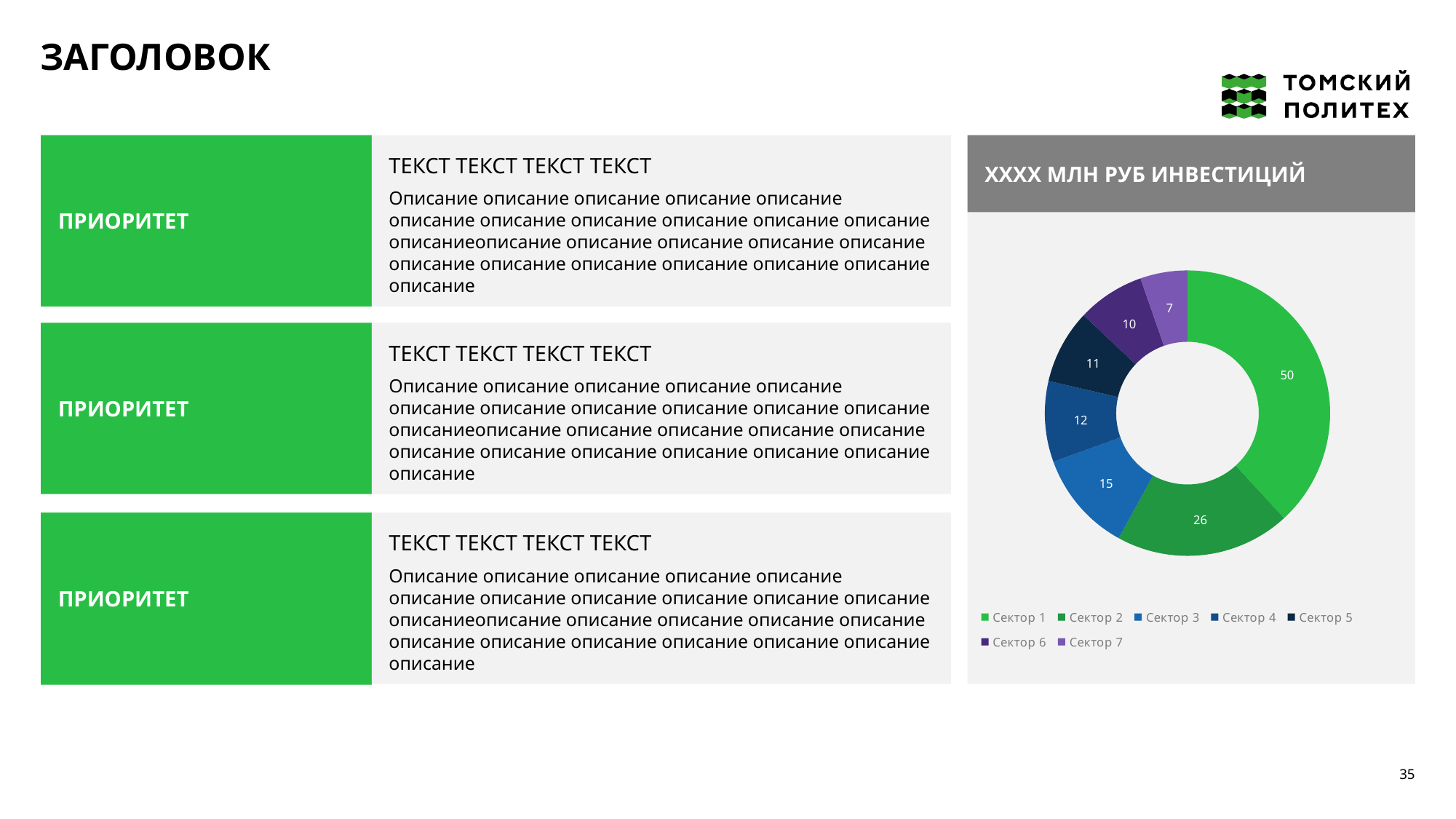
Which is larger, the value for Сектор 3 or the value for Сектор 6? Сектор 3 What is the total of all sector values in the chart? 131 What is the value for Сектор 3 in the chart? 15 What is the title of the chart? XXXX МЛН РУБ ИНВЕСТИЦИЙ What is the difference between the values for Сектор 4 and Сектор 5? 1 What kind of chart is shown on the slide? Doughnut chart What is the value for Сектор 6 in the chart? 10 What is the difference between the values for Сектор 1 and Сектор 2? 24 How many sectors does the chart show? 7 Which sector has the largest value in the chart? Сектор 1 What is the value for Сектор 1 in the chart? 50 Which sector has the smallest value in the chart? Сектор 7